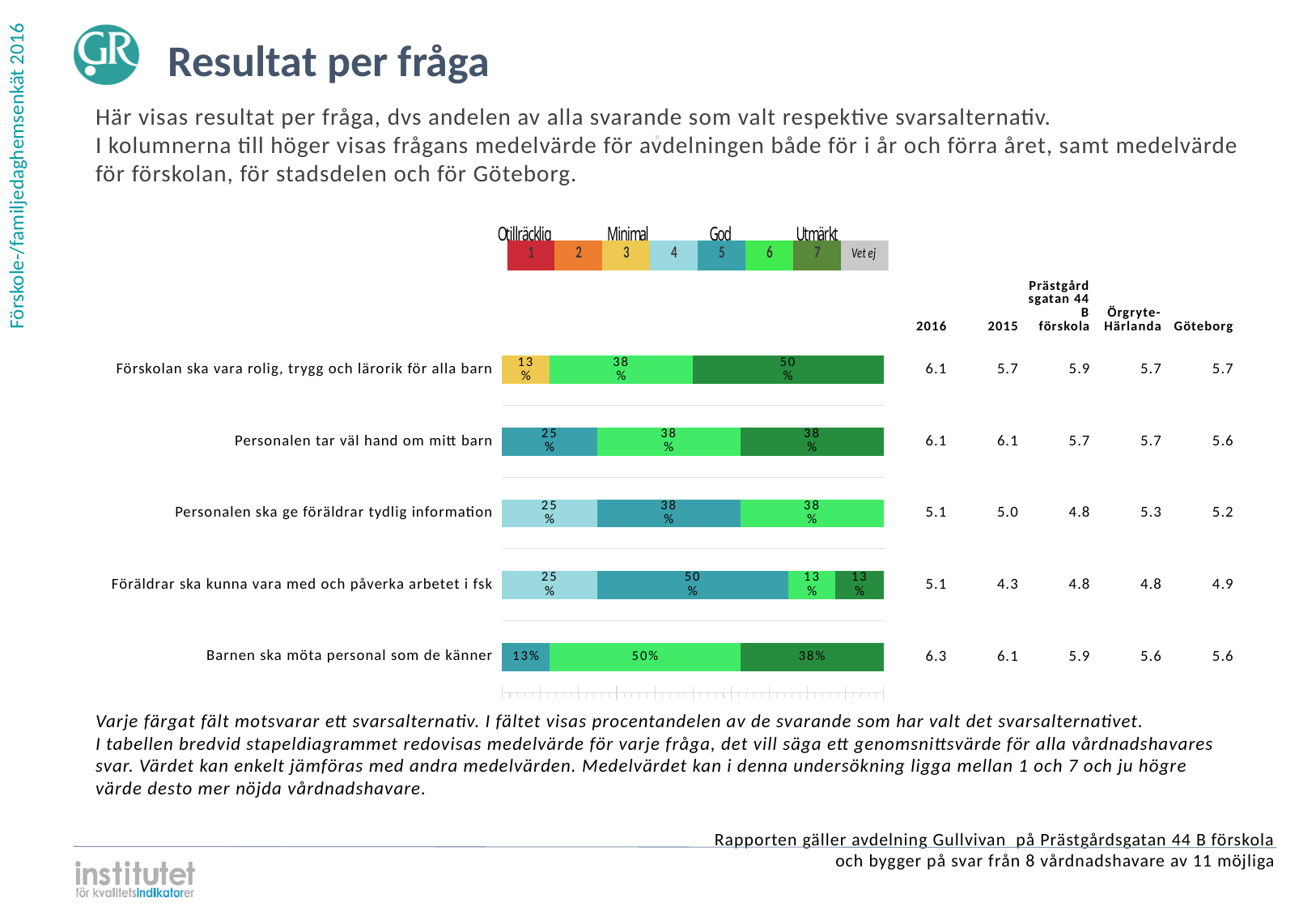
What percentage of respondents chose answer alternative 7 (dark green) for 'Förskolan ska vara rolig, trygg och lärorik för alla barn'? 50% What is the 2015 mean value for 'Föräldrar ska kunna vara med och påverka arbetet i fsk'? 4.3 Which question has the lowest 2015 mean value? Föräldrar ska kunna vara med och påverka arbetet i fsk How many questions (categories) are shown in the bar chart? 5 What is the 2016 mean value for 'Barnen ska möta personal som de känner'? 6.3 Which question has the highest 2016 mean value? Barnen ska möta personal som de känner What is the difference between the 2016 and 2015 mean values for 'Föräldrar ska kunna vara med och påverka arbetet i fsk'? 0.8 For 'Personalen ska ge föräldrar tydlig information', which is larger: the 2016 mean for the department or the mean for Örgryte-Härlanda? Örgryte-Härlanda What percentage of respondents chose answer alternative 5 (teal) for 'Föräldrar ska kunna vara med och påverka arbetet i fsk'? 50% What kind of chart is used to show the share of respondents choosing each answer alternative? Stacked bar chart What is the Göteborg mean value for 'Personalen tar väl hand om mitt barn'? 5.6 What label does the legend give to answer alternatives 1 and 2? Otillräcklig